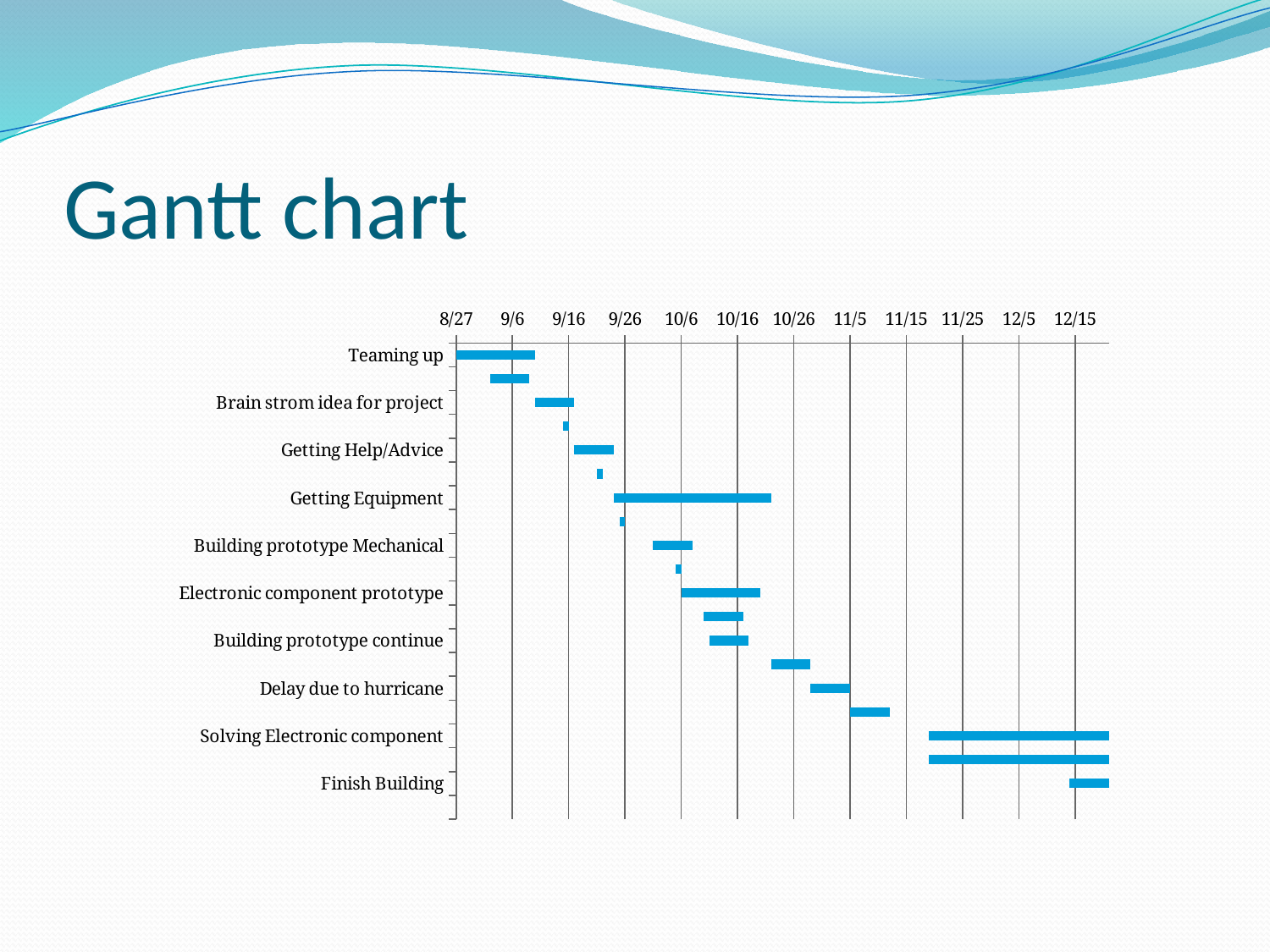
How many date labels are shown along the horizontal axis of the chart? 12 Does the bar for Teaming up start before or after 9/6? before What is the first date label on the horizontal axis? 8/27 How many task labels are listed on the vertical axis of the chart? 10 What kind of chart is shown on the slide? bar chart (Gantt chart) Which labeled task has the bar positioned furthest to the right (latest in time)? Finish Building What is the title of the slide? Gantt chart Does the bar for Finish Building start before or after 12/5? after Which task is listed first (at the top) on the vertical axis? Teaming up Which task is listed last (at the bottom) on the vertical axis? Finish Building Does the bar for Getting Equipment extend past 10/16? yes What is the last date label on the horizontal axis? 12/15